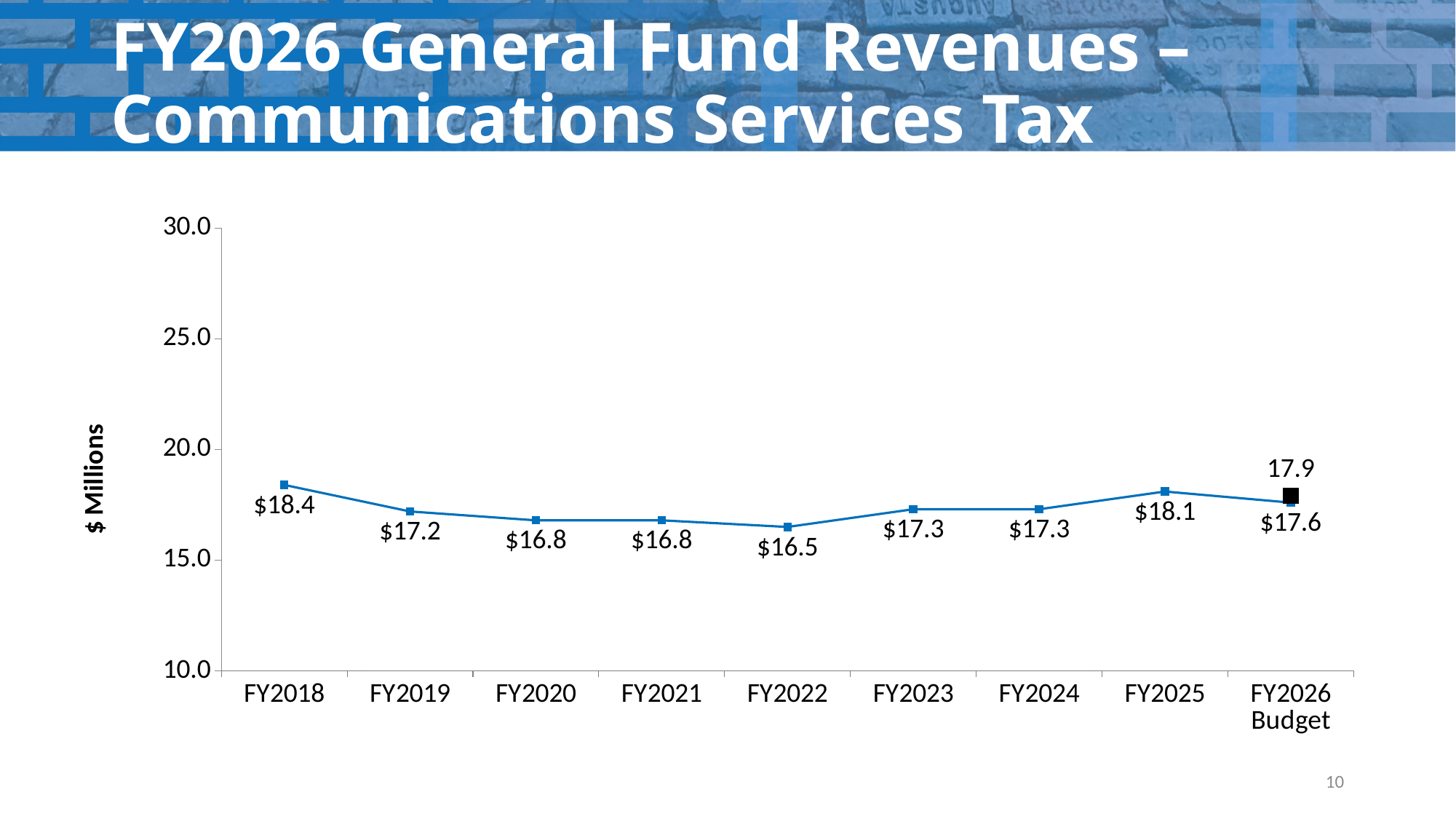
Which fiscal year has the highest value on the line? FY2018 What is the value for FY2025? $18.1 What kind of chart is shown on the slide? Line chart What is the difference between the FY2018 value and the FY2022 value? $1.9 Which fiscal year has the lowest value on the line? FY2022 What is the label on the vertical axis? $ Millions How many fiscal years are shown on the x axis? 9 What value is labelled on the blue line for FY2026 Budget? $17.6 What value is labelled next to the black square marker at FY2026 Budget? 17.9 What is the value for FY2018? $18.4 Which is larger, the value for FY2019 or the value for FY2023? FY2023 What is the value for FY2022? $16.5